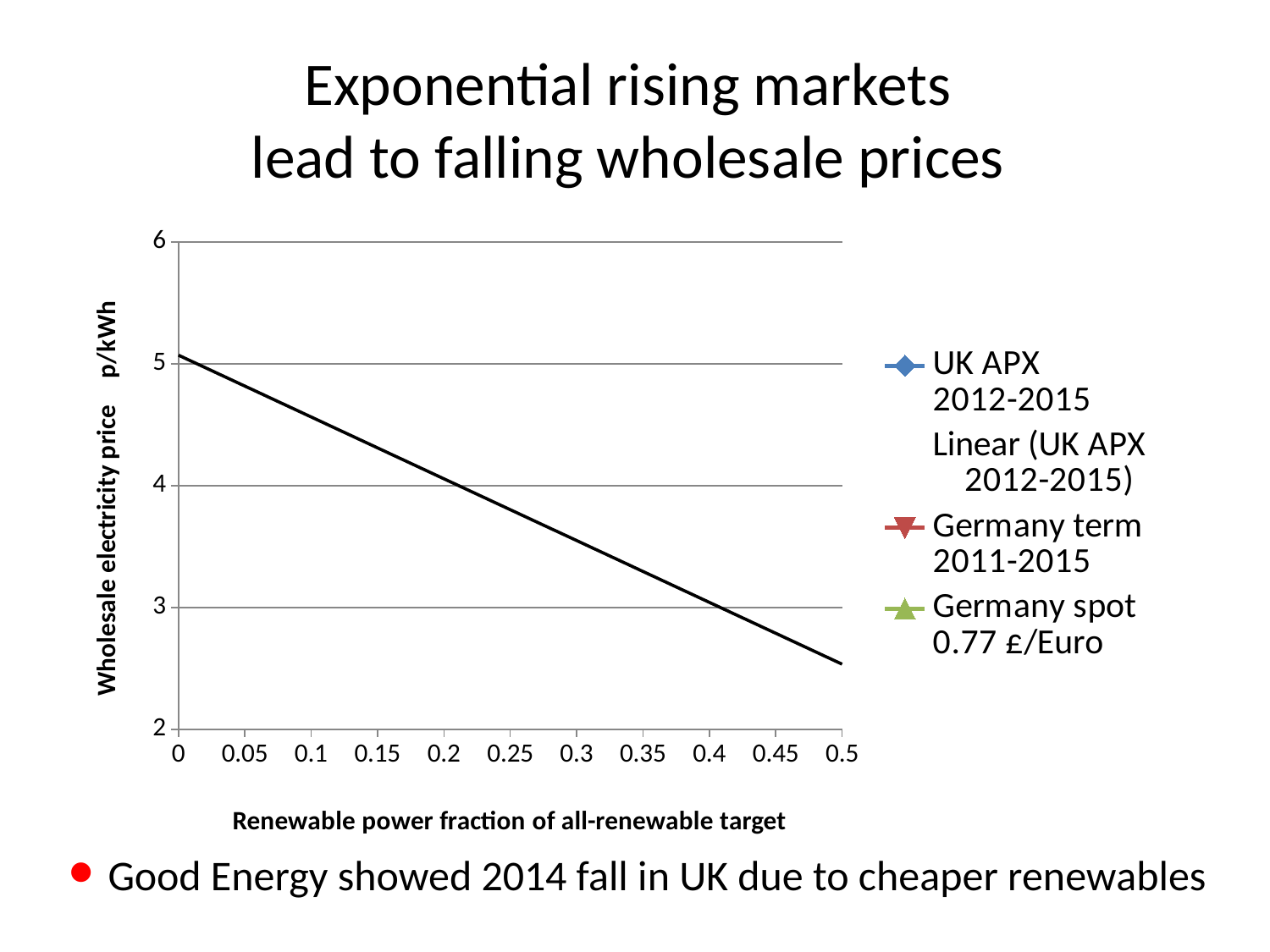
Is the value of the plotted line at a renewable power fraction of 0.1 greater or less than 4? greater How many entries does the chart legend list? 4 What kind of chart is shown on the slide? line chart Is the value of the plotted line at a renewable power fraction of 0.35 greater or less than 4? less Is the value of the plotted line at a renewable power fraction of 0.25 greater or less than 4? less Does the plotted line rise or fall as the renewable power fraction increases from 0 to 0.5? fall What is the label of the y axis of the chart? Wholesale electricity price p/kWh What is the label of the x axis of the chart? Renewable power fraction of all-renewable target